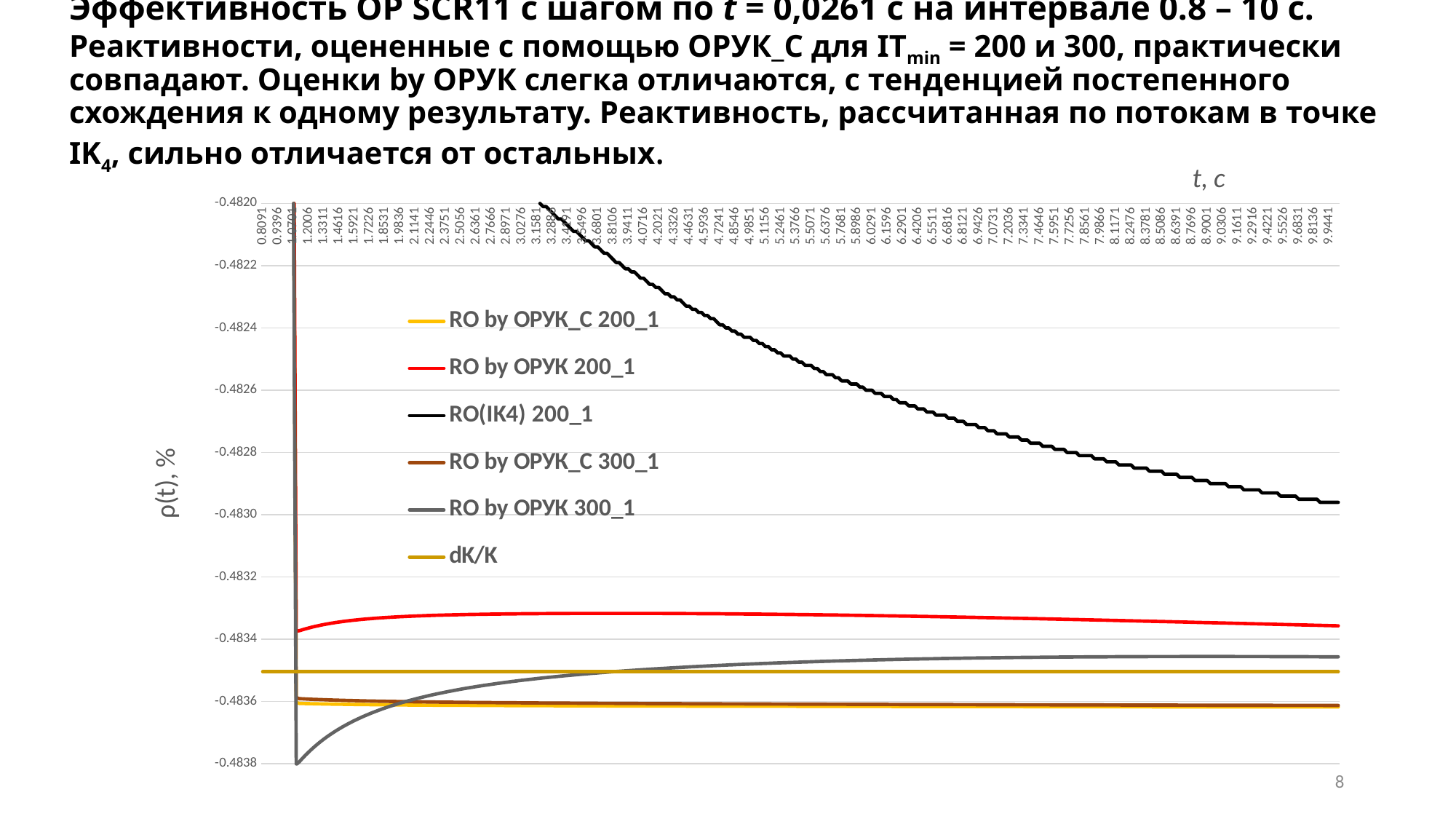
Is the value of dK/K greater or less than -0.4834? less Is the value of RO(IK4) 200_1 at t = 4.0716 greater or less than -0.4826? greater What colour is the RO(IK4) 200_1 line? black At the right end of the chart, which is larger: RO(IK4) 200_1 or RO by ОРУК 200_1? RO(IK4) 200_1 Which series has the highest values on the chart? RO(IK4) 200_1 Is the value of dK/K greater or less than -0.4836? greater What is the label of the vertical axis? ρ(t), % Does the RO by ОРУК 300_1 series rise or fall along the x axis? rise Which series reaches the lowest value on the chart? RO by ОРУК 300_1 Does the RO(IK4) 200_1 series rise or fall along the x axis? fall What kind of chart is shown on the slide? line chart How many series does the chart legend list? 6